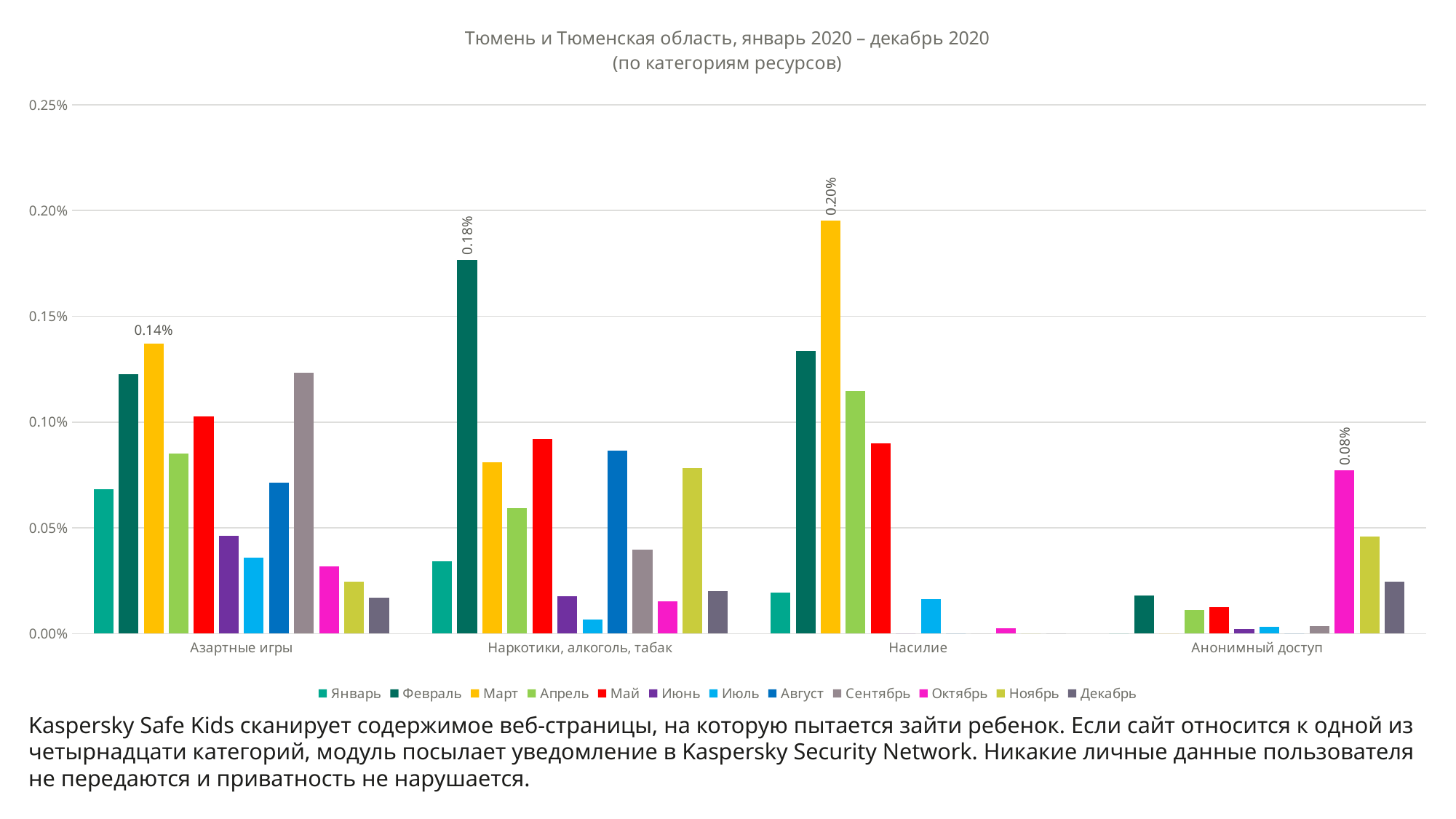
In the Наркотики, алкоголь, табак category, which is larger: Февраль or Март? Февраль Which month has the highest value in the Анонимный доступ category? Октябрь Is the value for Февраль in the Насилие category greater or less than 0.10%? greater What is the value for Март in the Насилие category? 0.20% How many resource categories are shown on the x axis? 4 What is the value for Февраль in the Наркотики, алкоголь, табак category? 0.18% What is the value for Март in the Азартные игры category? 0.14% Which month has the highest value in the Насилие category? Март How many series does the legend list? 12 Which month has the highest value in the Наркотики, алкоголь, табак category? Февраль What kind of chart is shown on the slide? bar chart What is the value for Октябрь in the Анонимный доступ category? 0.08%